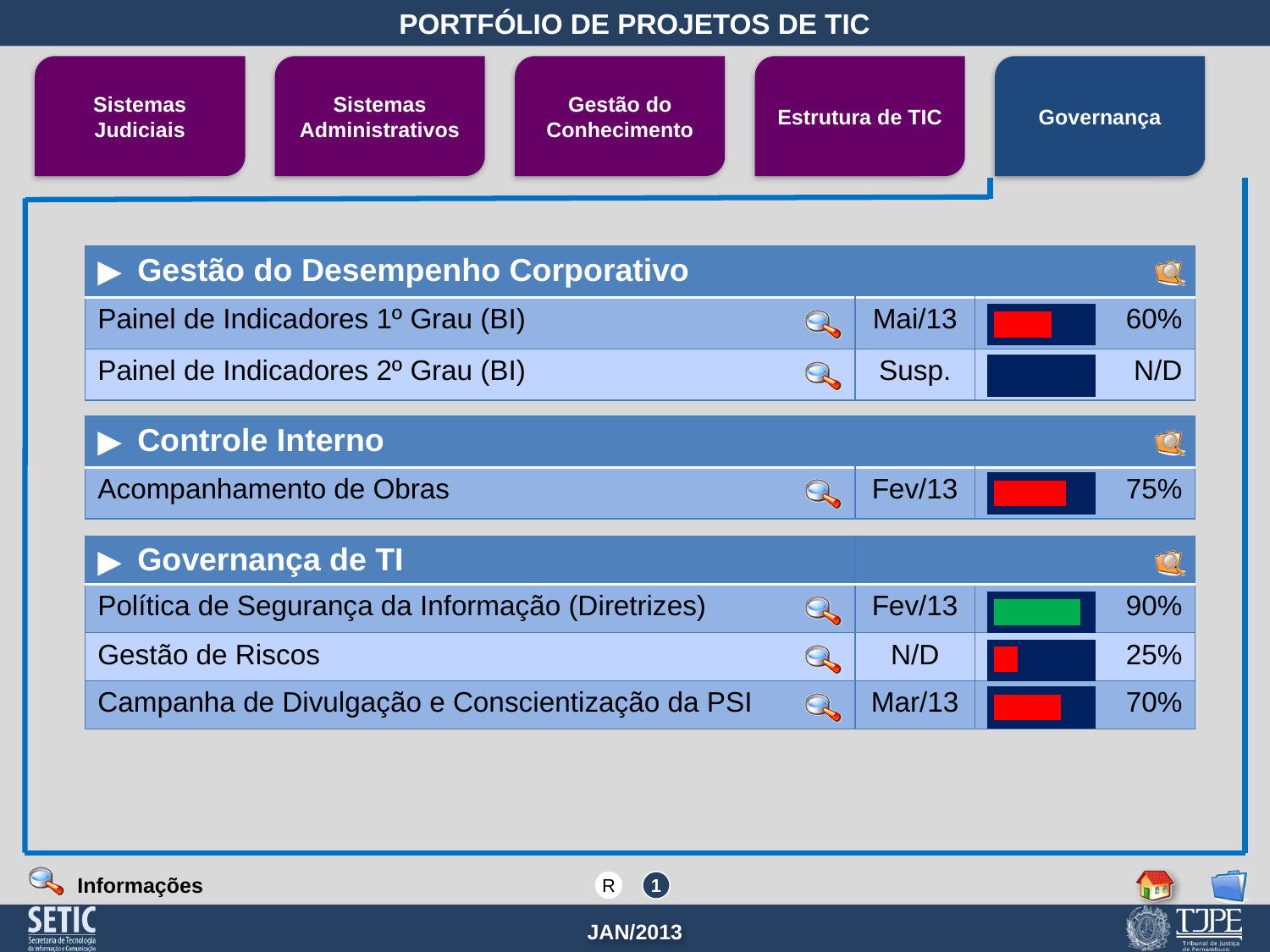
What completion percentage is shown for 'Acompanhamento de Obras'? 75% How many projects are listed with progress bars on the slide? 6 What completion percentage is shown for 'Campanha de Divulgação e Conscientização da PSI'? 70% What completion percentage is shown for the project 'Painel de Indicadores 1º Grau (BI)'? 60% Which project with a numeric percentage has the lowest completion percentage? Gestão de Riscos What completion percentage is shown for 'Gestão de Riscos'? 25% What completion percentage is shown for 'Política de Segurança da Informação (Diretrizes)'? 90% Which project's progress bar is coloured green rather than red? Política de Segurança da Informação (Diretrizes) Which has a higher completion percentage: 'Acompanhamento de Obras' or 'Painel de Indicadores 1º Grau (BI)'? Acompanhamento de Obras Which project has the highest completion percentage on its progress bar? Política de Segurança da Informação (Diretrizes) What date is shown for the project 'Painel de Indicadores 1º Grau (BI)'? Mai/13 What is the difference in percentage points between the completion of 'Política de Segurança da Informação (Diretrizes)' and 'Gestão de Riscos'? 65 percentage points